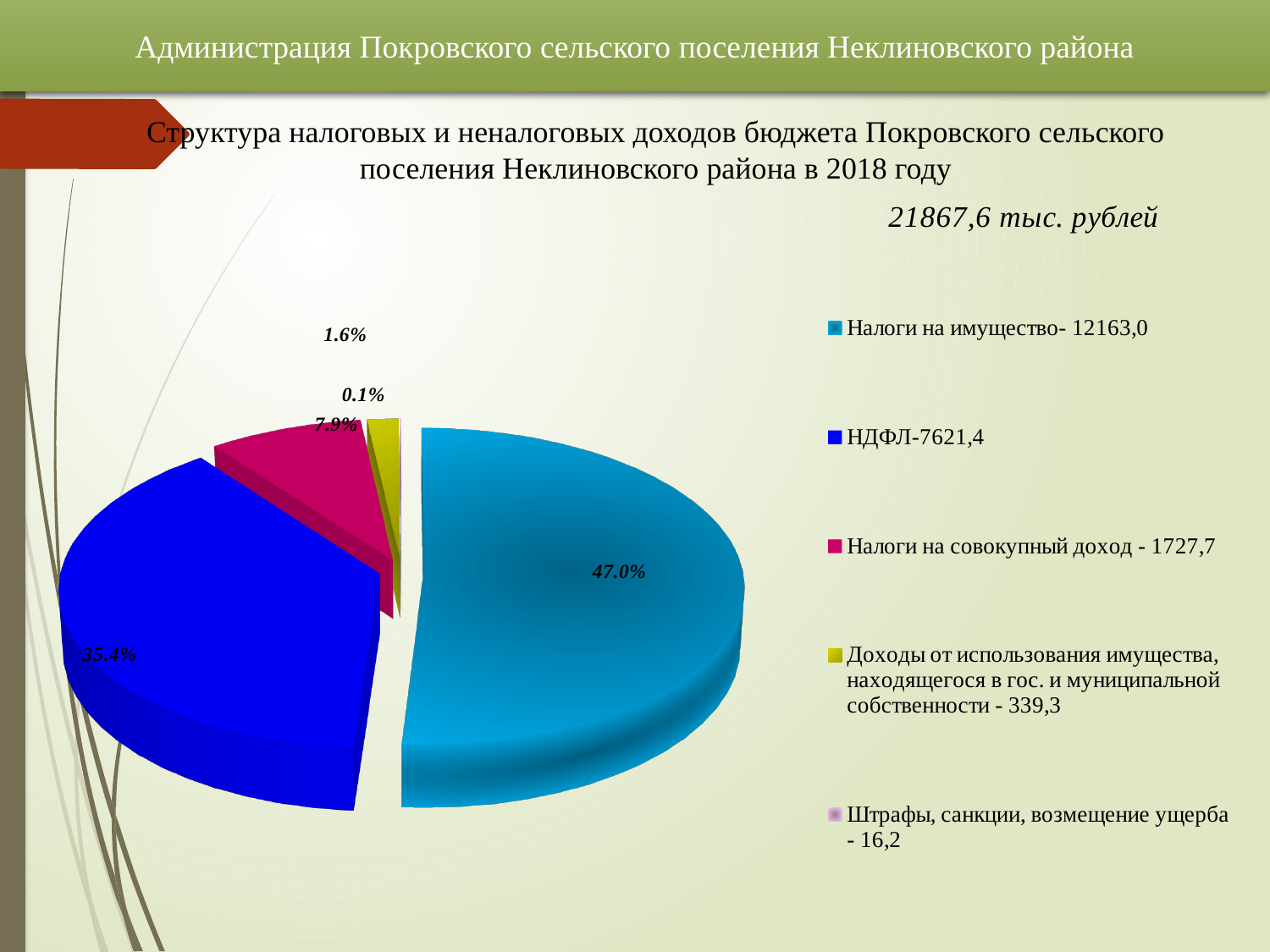
Which category has the largest slice of the pie? Налоги на имущество How many entries does the legend list? 5 How many slices does the pie chart have? 5 What value in тыс. рублей does the legend give for НДФЛ? 7621,4 What share of the pie does Штрафы, санкции, возмещение ущерба take? 0.1% What kind of chart is shown on the slide? pie chart What share of the pie does Налоги на имущество take? 47.0% Which category has the smallest slice of the pie? Штрафы, санкции, возмещение ущерба What share of the pie does НДФЛ take? 35.4% Which is larger, the share for НДФЛ or the share for Налоги на совокупный доход? НДФЛ What is the difference in percentage points between the Налоги на имущество slice and the НДФЛ slice? 11.6%